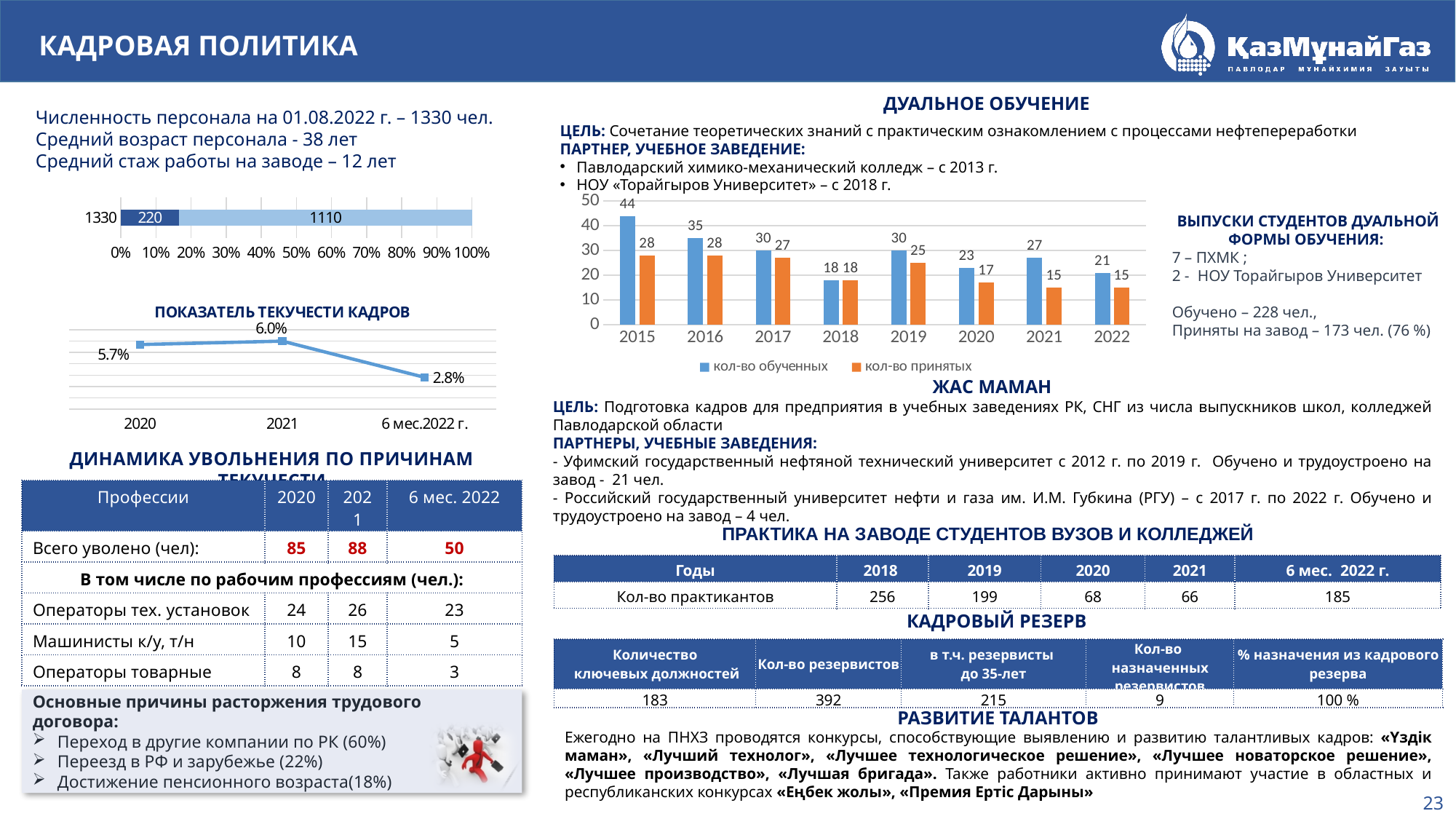
In the line chart 'ПОКАЗАТЕЛЬ ТЕКУЧЕСТИ КАДРОВ', what is the value for 2021? 6.0% In the dual training bar chart, what is the difference between 'кол-во обученных' and 'кол-во принятых' in 2015? 16 In the dual training bar chart (ДУАЛЬНОЕ ОБУЧЕНИЕ), what is the value of 'кол-во обученных' for 2015? 44 How many years are shown on the x axis of the dual training bar chart? 8 In the stacked horizontal bar chart at the top left, what is the total of the two segments (220 and 1110)? 1330 In the dual training bar chart, what is the value of 'кол-во принятых' for 2020? 17 What type of chart is 'ПОКАЗАТЕЛЬ ТЕКУЧЕСТИ КАДРОВ'? Line chart In the dual training bar chart, which year has the highest value of 'кол-во обученных'? 2015 In the dual training bar chart, which year has the lowest value of 'кол-во принятых'? 2021 and 2022 (15 each) In the line chart 'ПОКАЗАТЕЛЬ ТЕКУЧЕСТИ КАДРОВ', which period has the lowest value? 6 мес.2022 г. In the dual training bar chart, which is larger in 2019: 'кол-во обученных' or 'кол-во принятых'? кол-во обученных How many series does the legend of the dual training bar chart list? 2